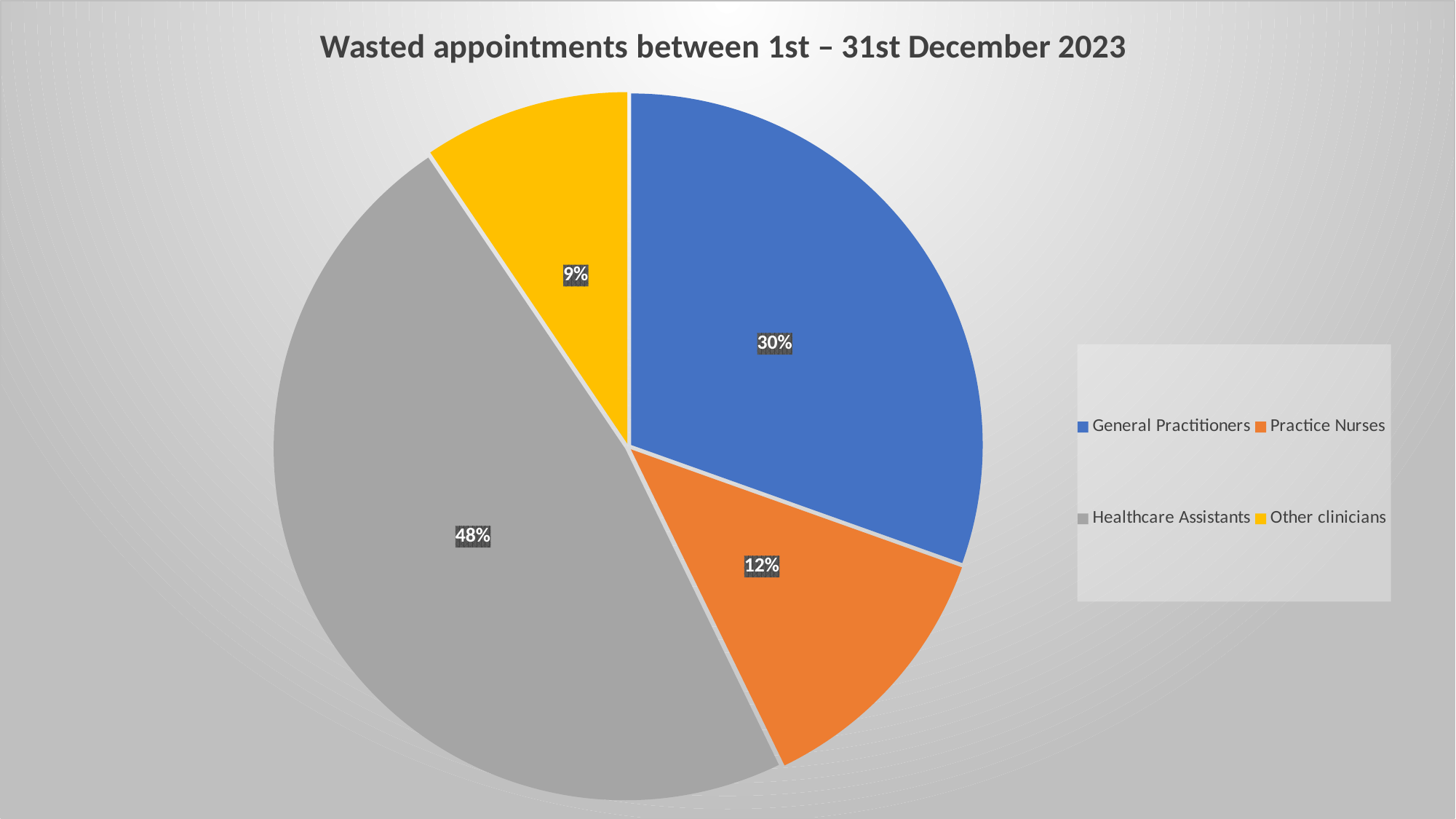
What share of wasted appointments is attributed to General Practitioners? 30% Which has a larger share, Practice Nurses or Other clinicians? Practice Nurses How many categories are shown in the pie chart? 4 What share of wasted appointments is attributed to Other clinicians? 9% What kind of chart is shown on the slide? pie chart What share of wasted appointments is attributed to Practice Nurses? 12% Which colour represents Healthcare Assistants in the chart? grey What is the title of the chart? Wasted appointments between 1st – 31st December 2023 Which category has the largest share of wasted appointments? Healthcare Assistants What share of wasted appointments is attributed to Healthcare Assistants? 48% What is the difference in percentage points between Healthcare Assistants and General Practitioners? 18 Which category has the smallest share of wasted appointments? Other clinicians